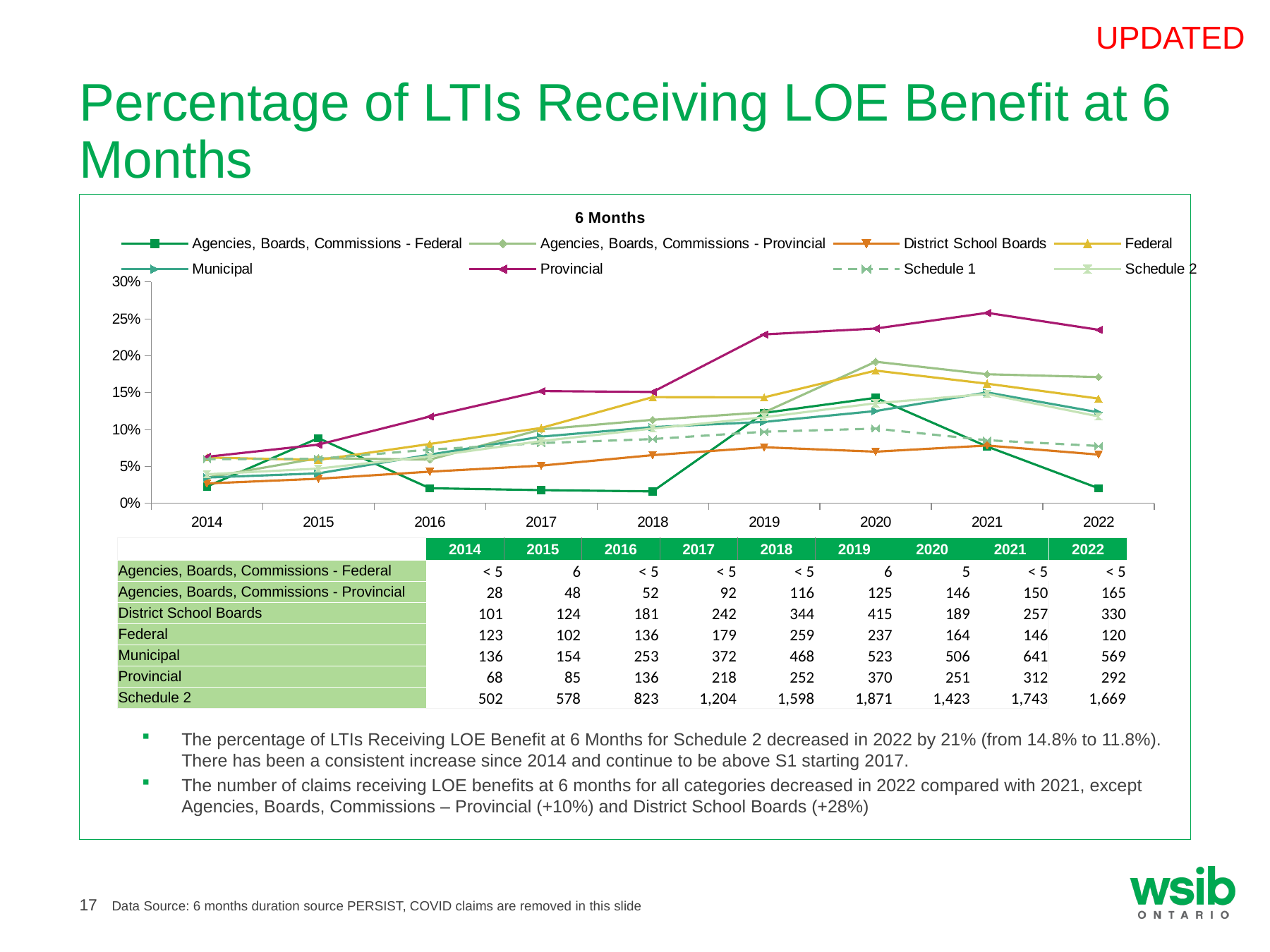
How many series does the chart legend list? 8 Which series is drawn with a dashed line? Schedule 1 Is the value for Schedule 1 in 2022 greater or less than 10%? less Does the Provincial line rise or fall from 2014 to 2021? rise How many years are shown along the x axis of the chart? 9 Which series has the highest value in 2022? Provincial In 2020, which is larger: Provincial or Municipal? Provincial In the data table below the chart, what is the value for Municipal in 2021? 641 Is the value for Agencies, Boards, Commissions - Federal in 2022 greater or less than 5%? less Which series has the lowest value in 2022? Agencies, Boards, Commissions - Federal What kind of chart is shown on the slide? line chart Is the value for Provincial in 2021 greater or less than 20%? greater